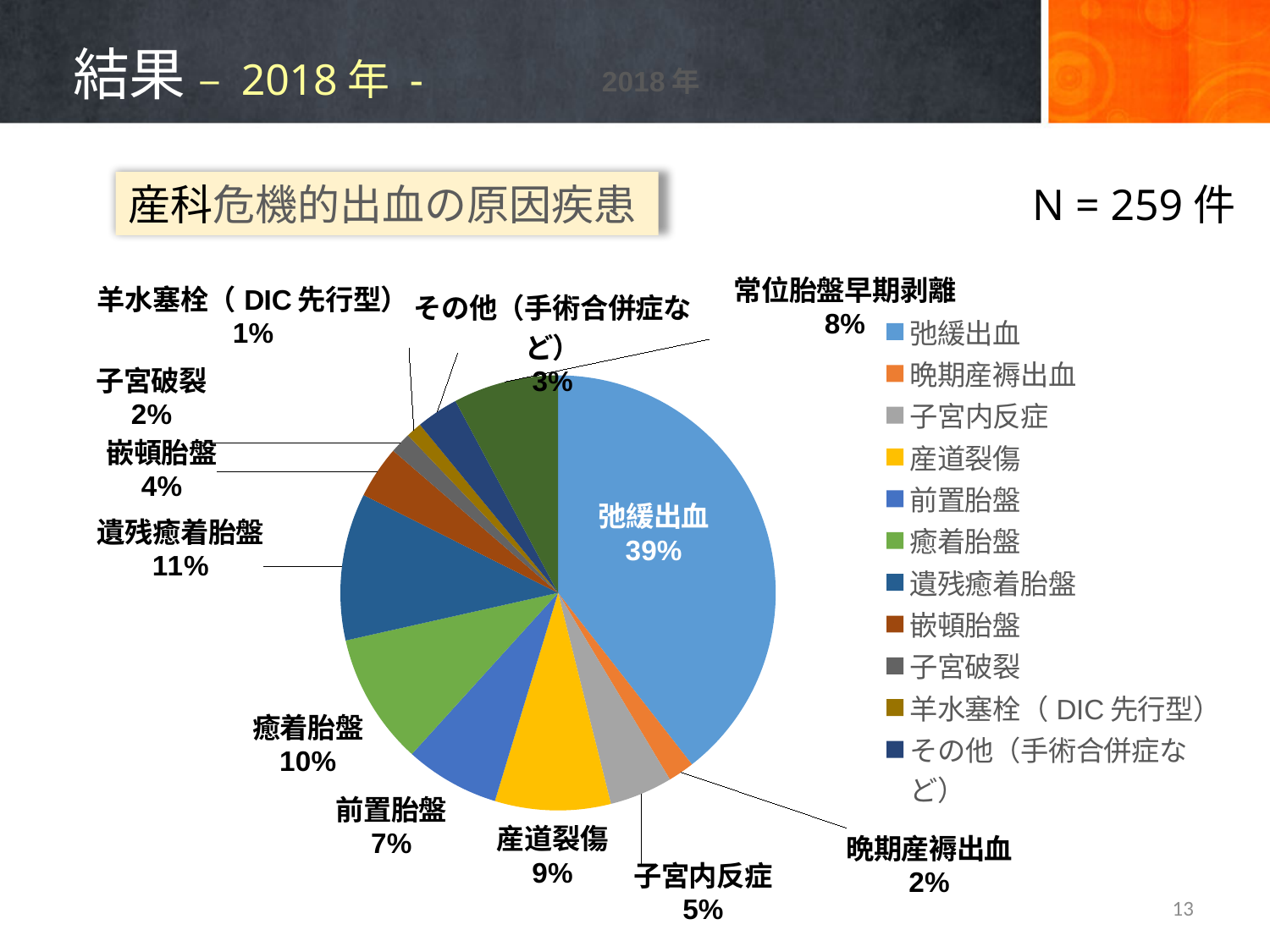
What percentage is shown for 常位胎盤早期剥離? 8% What is the title shown above the pie chart? 産科危機的出血の原因疾患 What percentage is shown for 遺残癒着胎盤? 11% Which category has the smallest share of the pie? 羊水塞栓（DIC先行型） Which is larger, the share for 産道裂傷 or the share for 前置胎盤? 産道裂傷 What kind of chart is shown on the slide? pie chart How many slices does the pie chart have? 12 What share of the pie does 弛緩出血 account for? 39% What percentage is shown for 羊水塞栓（DIC先行型）? 1% What is the difference in percentage points between 弛緩出血 and 遺残癒着胎盤? 28 Which category has the largest share of the pie? 弛緩出血 What is the total number of cases (N) stated on the slide? 259